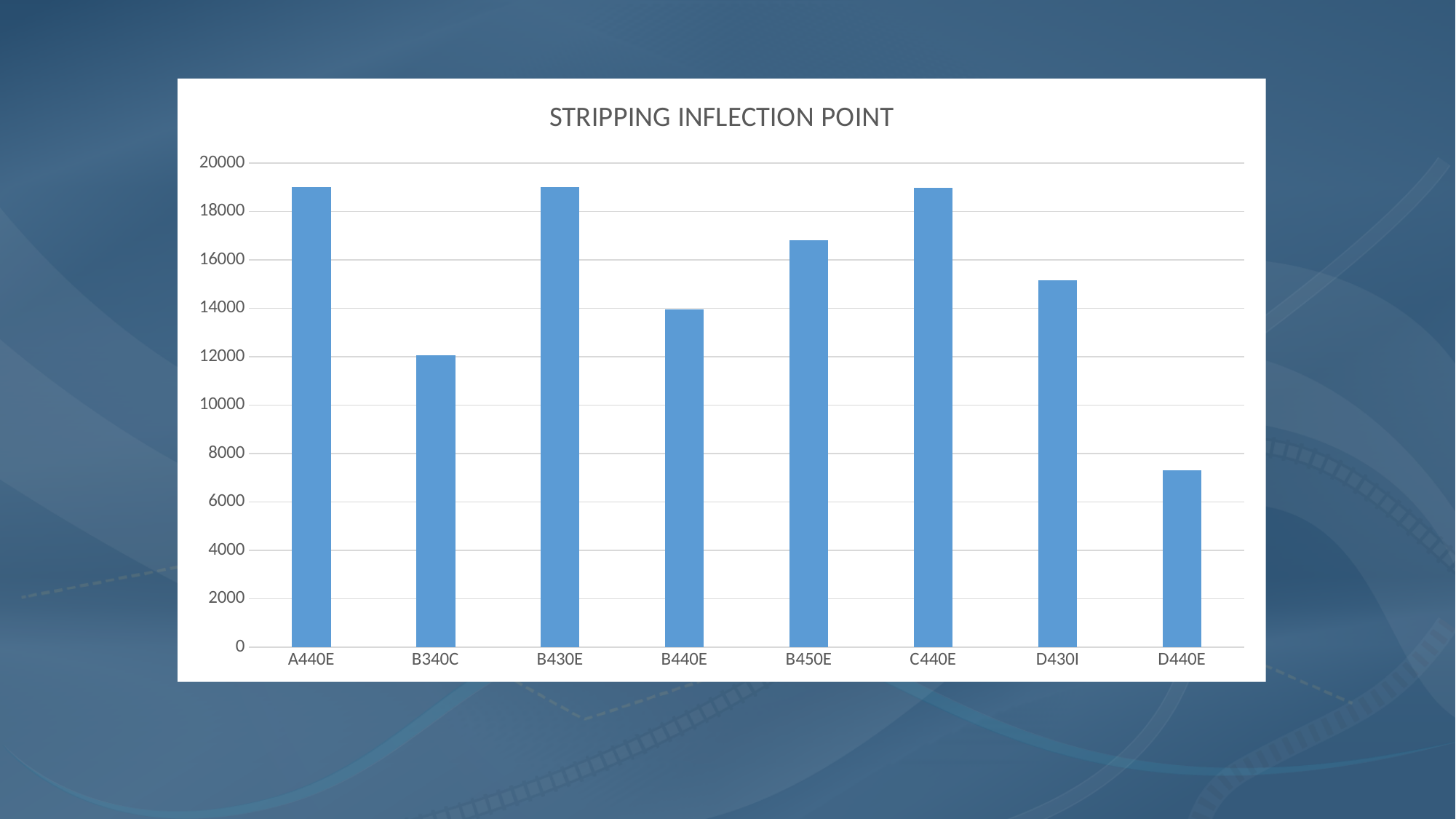
Which has the larger value, B340C or B440E? B440E Which has the larger value, B450E or D430I? B450E Is the value for B450E greater or less than 16000? greater Is the value for B340C greater or less than 10000? greater How many categories are shown on the x axis of the chart? 8 Which category has the lowest value in the chart? D440E Is the value for D440E greater or less than 8000? less What kind of chart is shown on the slide? bar chart What is the title of the chart? STRIPPING INFLECTION POINT